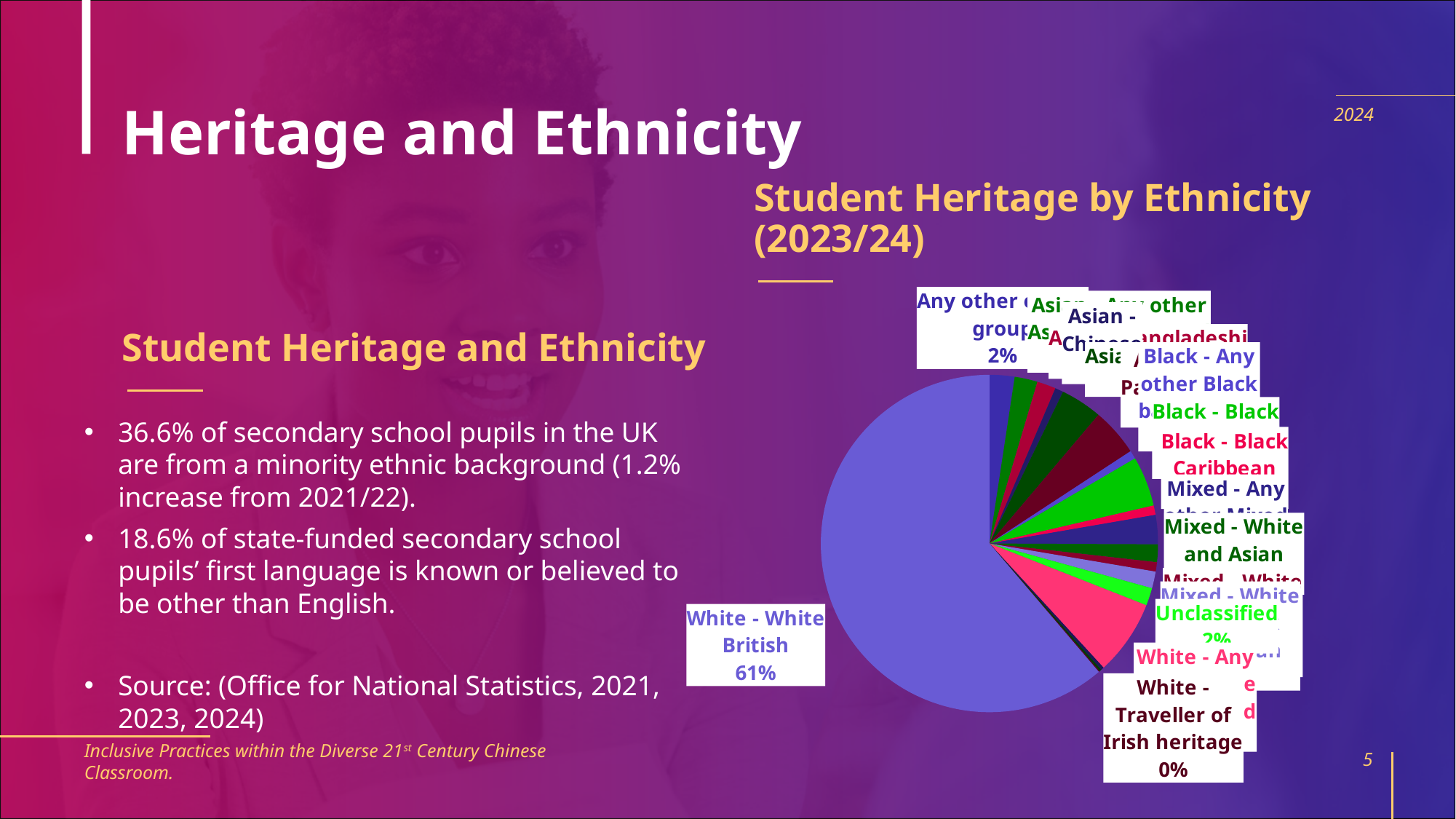
What kind of chart is shown under the title 'Student Heritage by Ethnicity (2023/24)'? pie chart What is the title of the chart on the slide? Student Heritage by Ethnicity (2023/24) Which is larger in the pie chart: White - White British or Unclassified? White - White British What share of the pie does White - White British represent? 61% In the pie chart, what percentage is shown for White - White British? 61% In the pie chart, what percentage is shown for White - Traveller of Irish heritage? 0% In the pie chart, what percentage is shown for Unclassified? 2% Which is larger in the pie chart: Unclassified or White - Traveller of Irish heritage? Unclassified What is the difference between the White - White British share and the Unclassified share in the pie chart? 59% Which category has the largest slice in the pie chart? White - White British